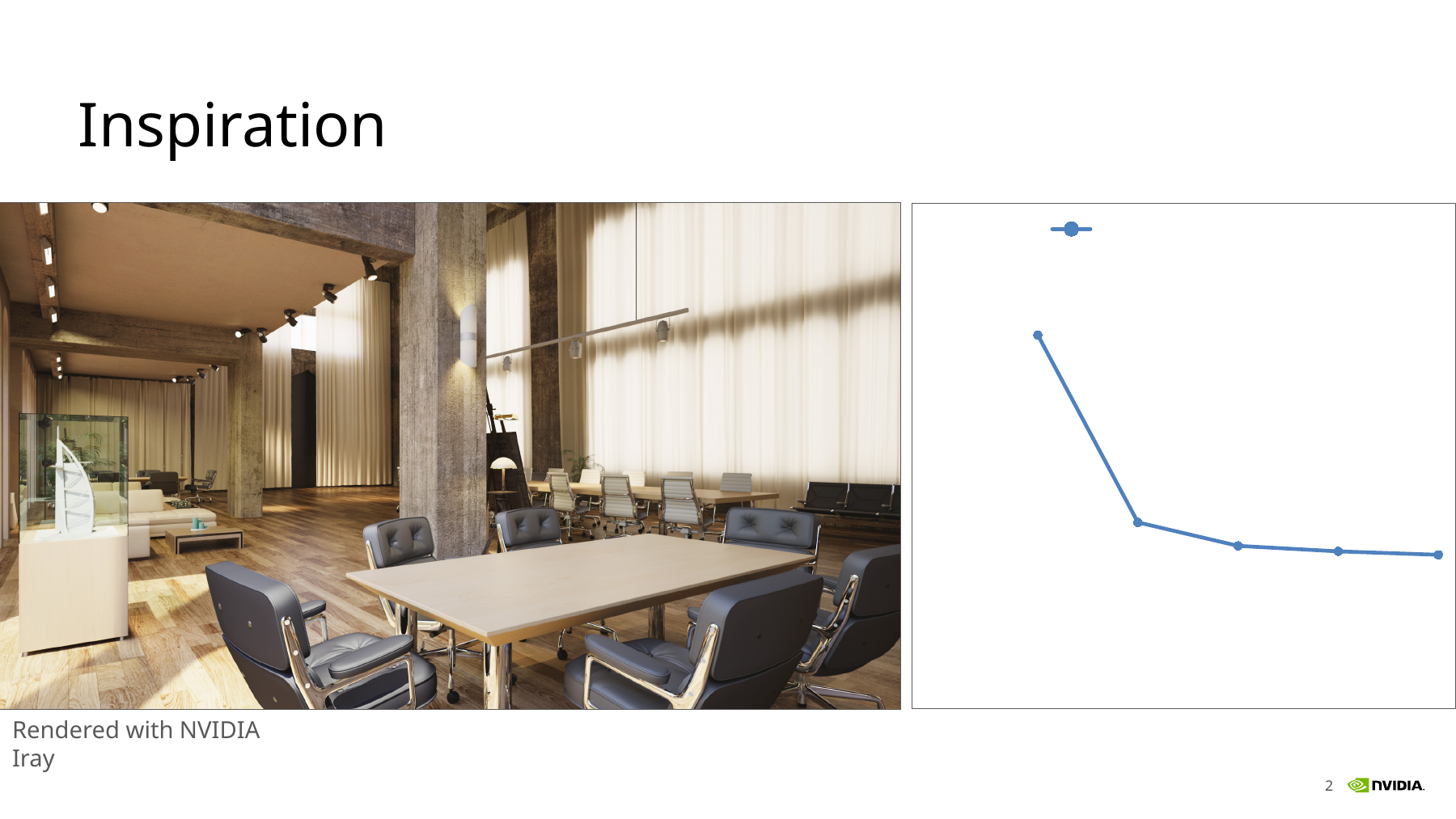
In the line chart on the right, which point is the highest: the leftmost or the rightmost? leftmost Does the line chart on the right show any axis labels or data labels? No In the line chart on the right, is the leftmost point higher or lower than the rightmost point? higher Do the values in the line chart on the right rise or fall from left to right? fall In the line chart on the right, is the second point from the left higher or lower than the first point? lower What kind of chart is shown on the right side of the slide? line chart How many series does the legend of the line chart on the right list? 1 What colour is the line in the chart on the right? blue How many data points are plotted on the line chart on the right? 5